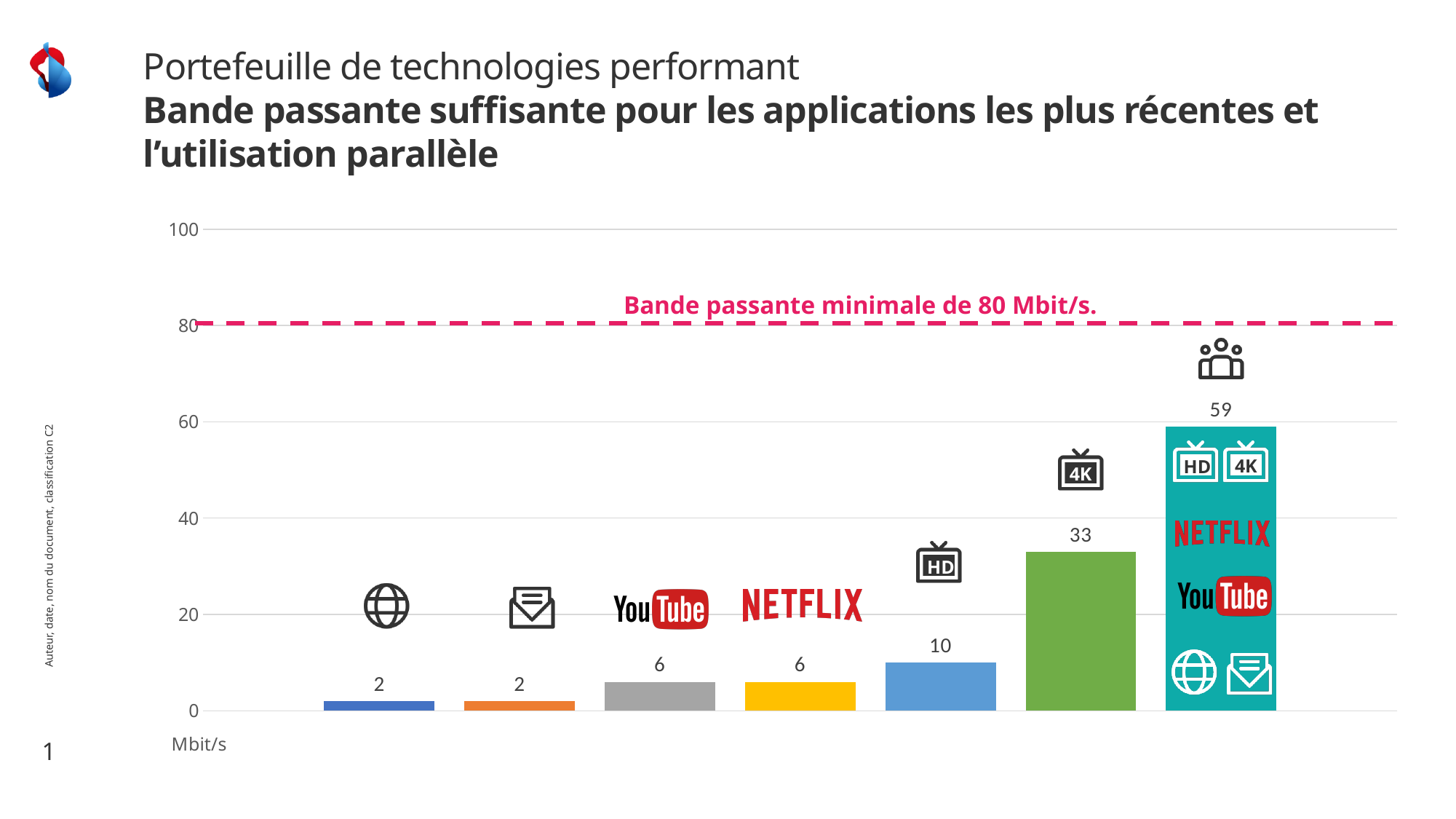
What minimum bandwidth does the dashed line on the chart indicate? 80 Mbit/s What is the difference between the 4K bar (33) and the HD bar (10)? 23 What is the value of the bar marked with the Netflix logo? 6 What type of chart is shown on the slide? bar chart What is the value of the bar marked with the HD television icon? 10 What is the value of the bar marked with the 4K television icon? 33 What is the value of the tallest bar, the one on the far right with the group-of-people icon? 59 How many bars are plotted in the chart? 7 What is the value of the bar marked with the YouTube logo? 6 Which is larger, the value of the 4K bar or the value of the HD bar? 4K bar What unit is shown below the vertical axis of the chart? Mbit/s What is the value of the first bar on the left, marked with the globe icon? 2